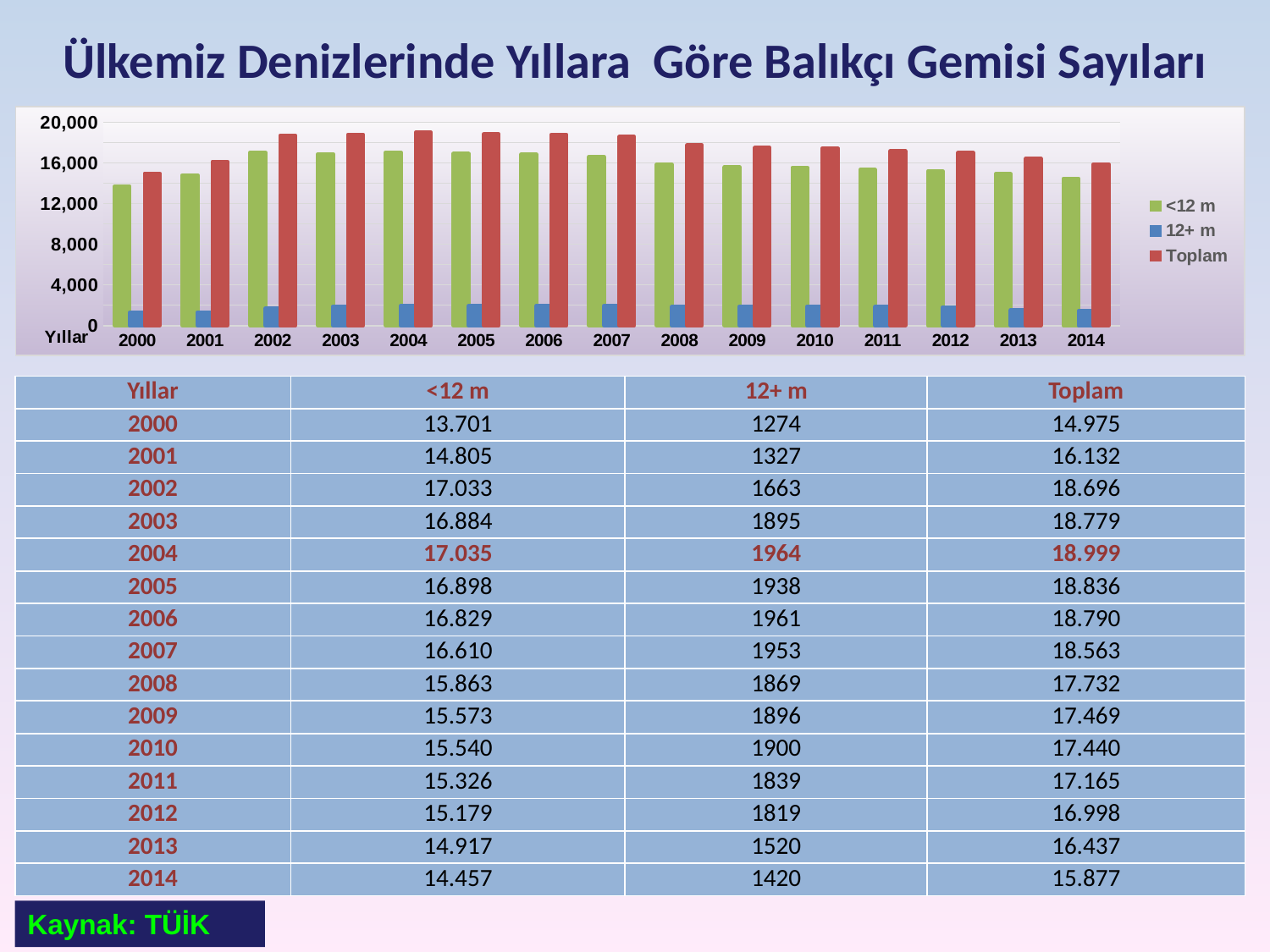
How many series does the chart legend list? 3 What kind of chart is shown on the slide? bar chart What is the 12+ m value for 2010? 1900 What is the difference between the Toplam value for 2014 and the Toplam value for 2000? 902 How many years are shown along the x axis of the chart? 15 Which year has the larger <12 m value, 2002 or 2003? 2002 Is the Toplam value for 2000 greater or less than 16,000? less Does the Toplam value rise or fall from 2004 to 2014? fall In which year is the Toplam value highest? 2004 In which year is the <12 m value lowest? 2000 What colour represents the Toplam series in the chart legend? red What is the Toplam value for 2004? 18.999